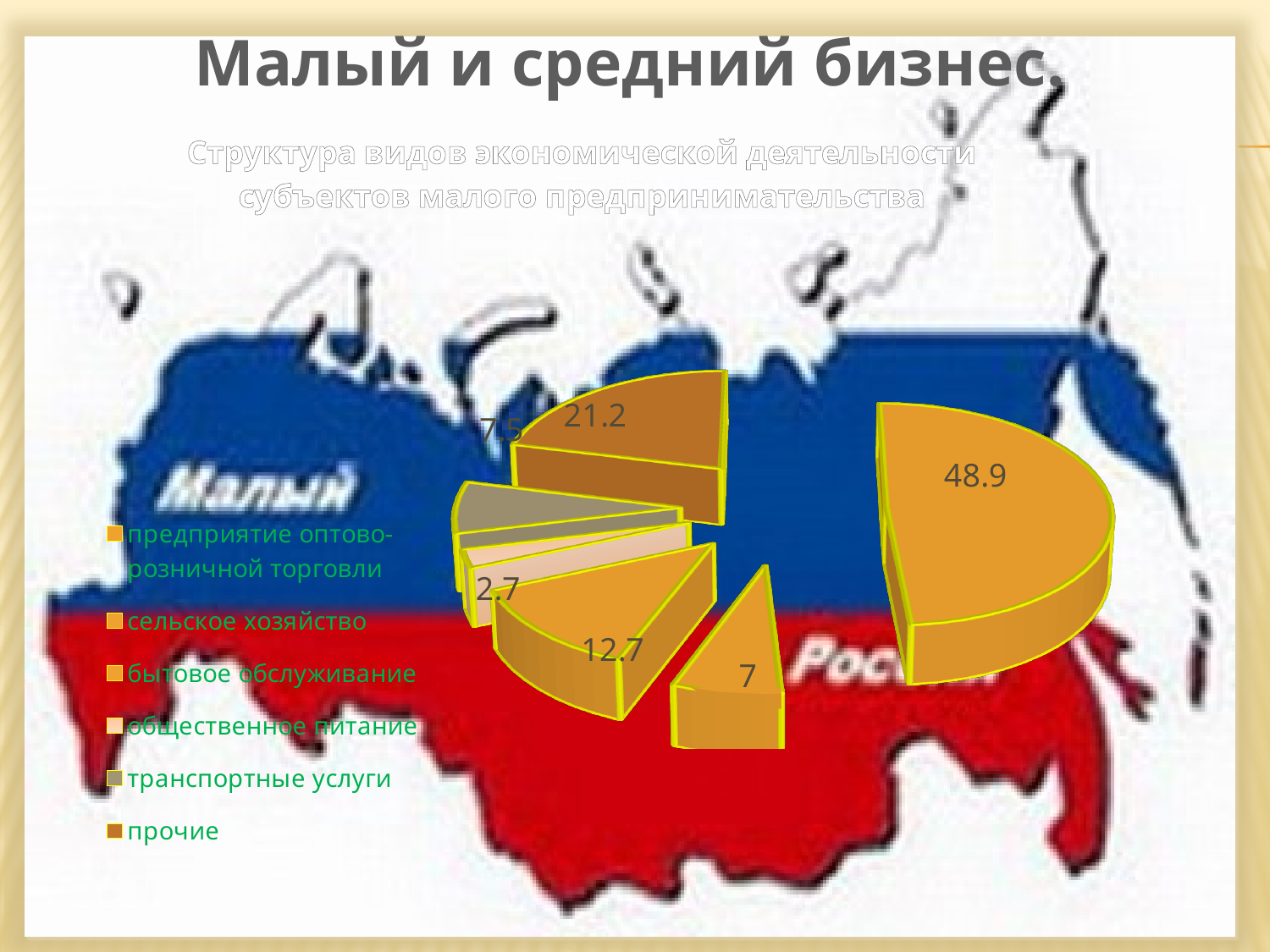
What is the value shown for транспортные услуги in the pie chart? 7.5 Which category has the smallest slice of the pie chart? общественное питание What is the value shown for the largest slice of the pie chart? 48.9 How many categories does the legend of the pie chart list? 6 Which category has the largest slice of the pie chart? предприятие оптово-розничной торговли What is the difference between the values for предприятие оптово-розничной торговли and прочие? 27.7 What is the value shown for прочие in the pie chart? 21.2 What kind of chart is shown on the slide? pie chart What is the value shown for общественное питание in the pie chart? 2.7 Which is larger in the pie chart: the value for прочие or the value for транспортные услуги? прочие What is the subtitle describing the pie chart on the slide? Структура видов экономической деятельности субъектов малого предпринимательства What is the difference between the values for транспортные услуги and общественное питание? 4.8